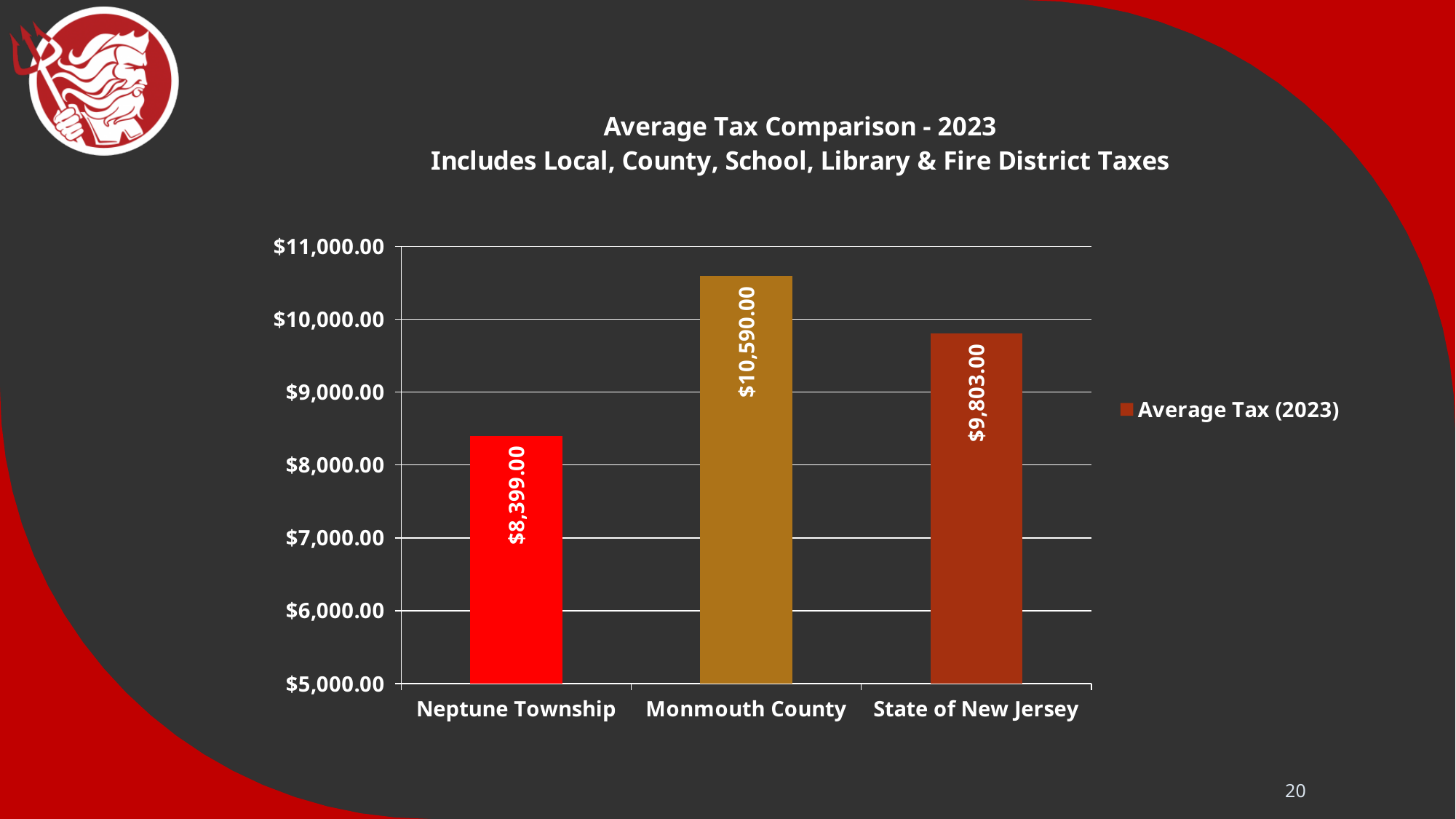
What is the average tax for the State of New Jersey? $9,803.00 What is the difference between the average tax for Monmouth County and Neptune Township? $2,191.00 Which has a higher average tax, the State of New Jersey or Neptune Township? State of New Jersey What is the average tax for Neptune Township? $8,399.00 What is the average tax for Monmouth County? $10,590.00 How many categories are shown on the chart? 3 What kind of chart is shown on the slide? Bar chart Which category has the lowest average tax? Neptune Township What is the difference between the average tax for the State of New Jersey and Neptune Township? $1,404.00 What series name does the legend list? Average Tax (2023) Is the value for Monmouth County greater or less than $10,000.00? greater Which category has the highest average tax? Monmouth County